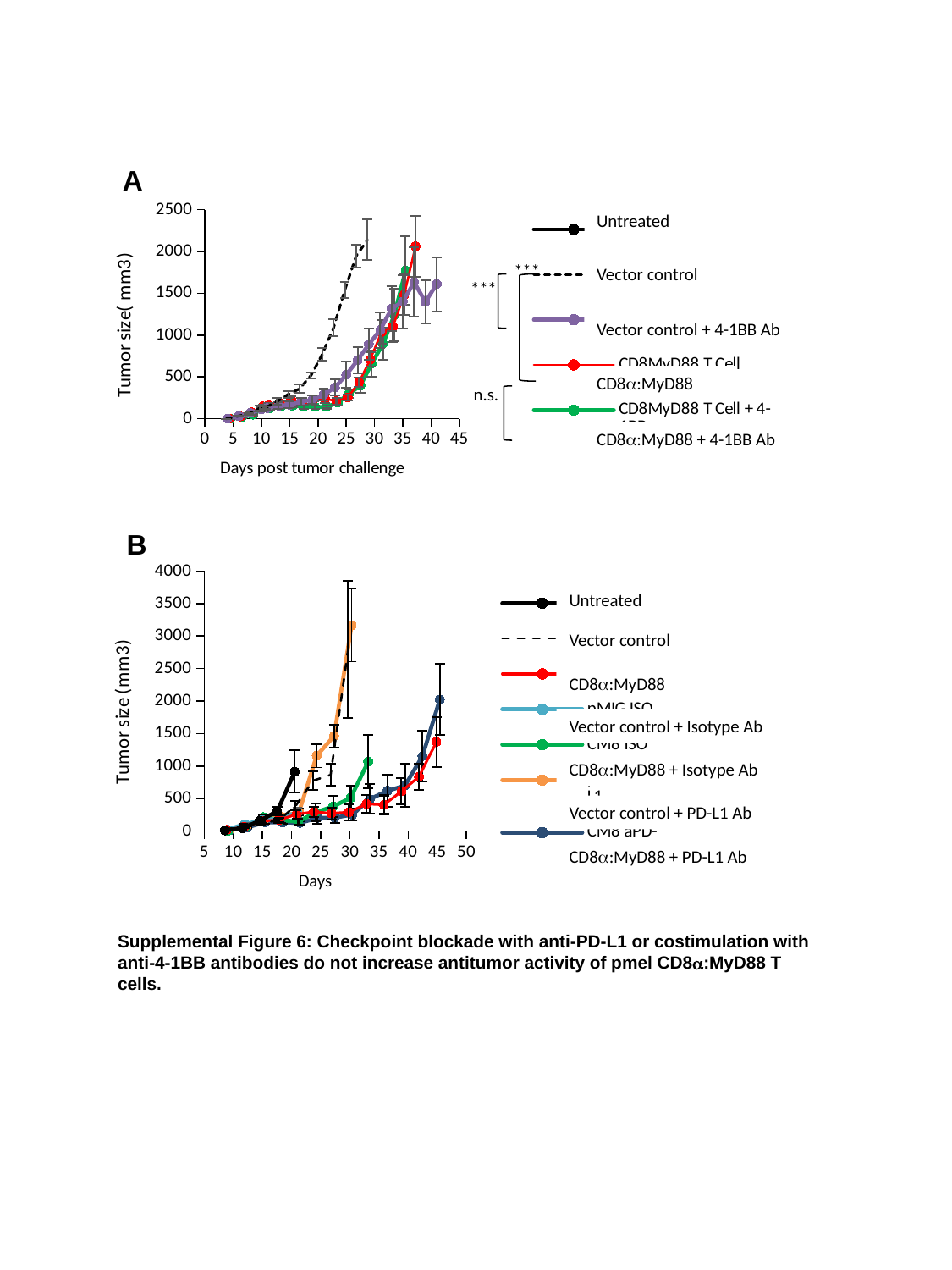
In chart A, does the tumor size for the Vector control + 4-1BB Ab series generally rise or fall over the days post tumor challenge? rise In chart B, is the CD8α:MyD88 + PD-L1 Ab tumor size at day 45 greater or less than 1500? greater In chart A, what is the x-axis title? Days post tumor challenge What kind of chart is chart A? line chart In chart B, which series reaches a higher peak tumor size: CD8α:MyD88 + Isotype Ab or Untreated? CD8α:MyD88 + Isotype Ab In chart B, is the Untreated tumor size at day 21 greater or less than 1500? less In chart A, is the Vector control tumor size at day 27 greater or less than 1500? greater In chart B, what is the y-axis title? Tumor size (mm3) In chart B, does the tumor size for the CD8α:MyD88 series generally rise or fall over the days? rise What kind of chart is chart B? line chart